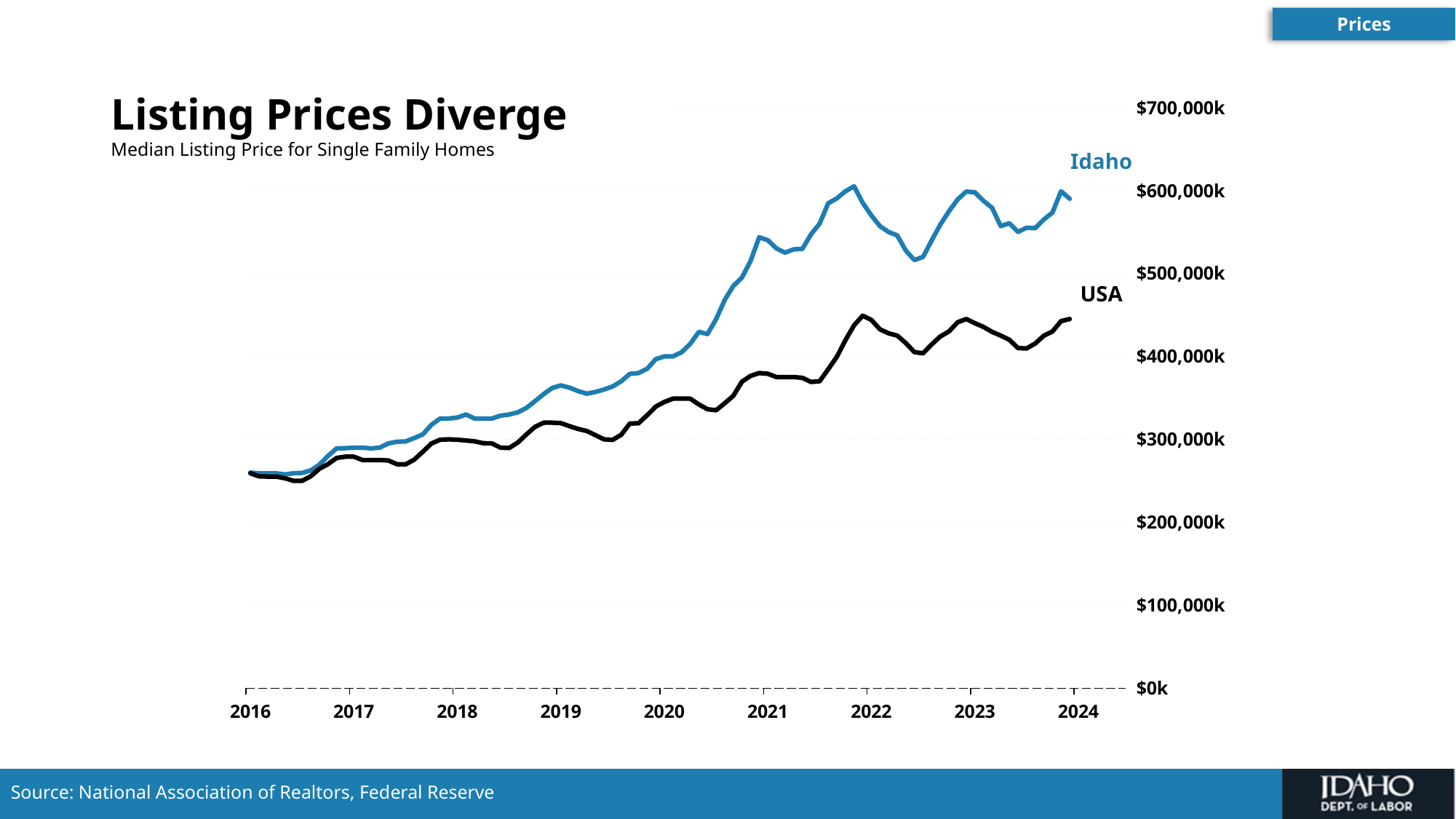
How many year labels are shown on the x axis? 9 Overall, do the Idaho median listing prices rise or fall from 2016 to 2024? rise Is the Idaho value at the end of the series (near 2024) greater or less than $500,000k? greater How many series are plotted on the chart? 2 Is the USA value at the end of the series (near 2024) greater or less than $400,000k? greater What is the title of the chart? Listing Prices Diverge What kind of chart is shown on the slide? line chart Which series has the higher median listing price at the end of 2023 (near the 2024 tick), Idaho or USA? Idaho Overall, do the USA median listing prices rise or fall from 2016 to 2024? rise Is the Idaho value at the start of 2016 greater or less than $300,000k? less Which two series are plotted on the chart? Idaho and USA